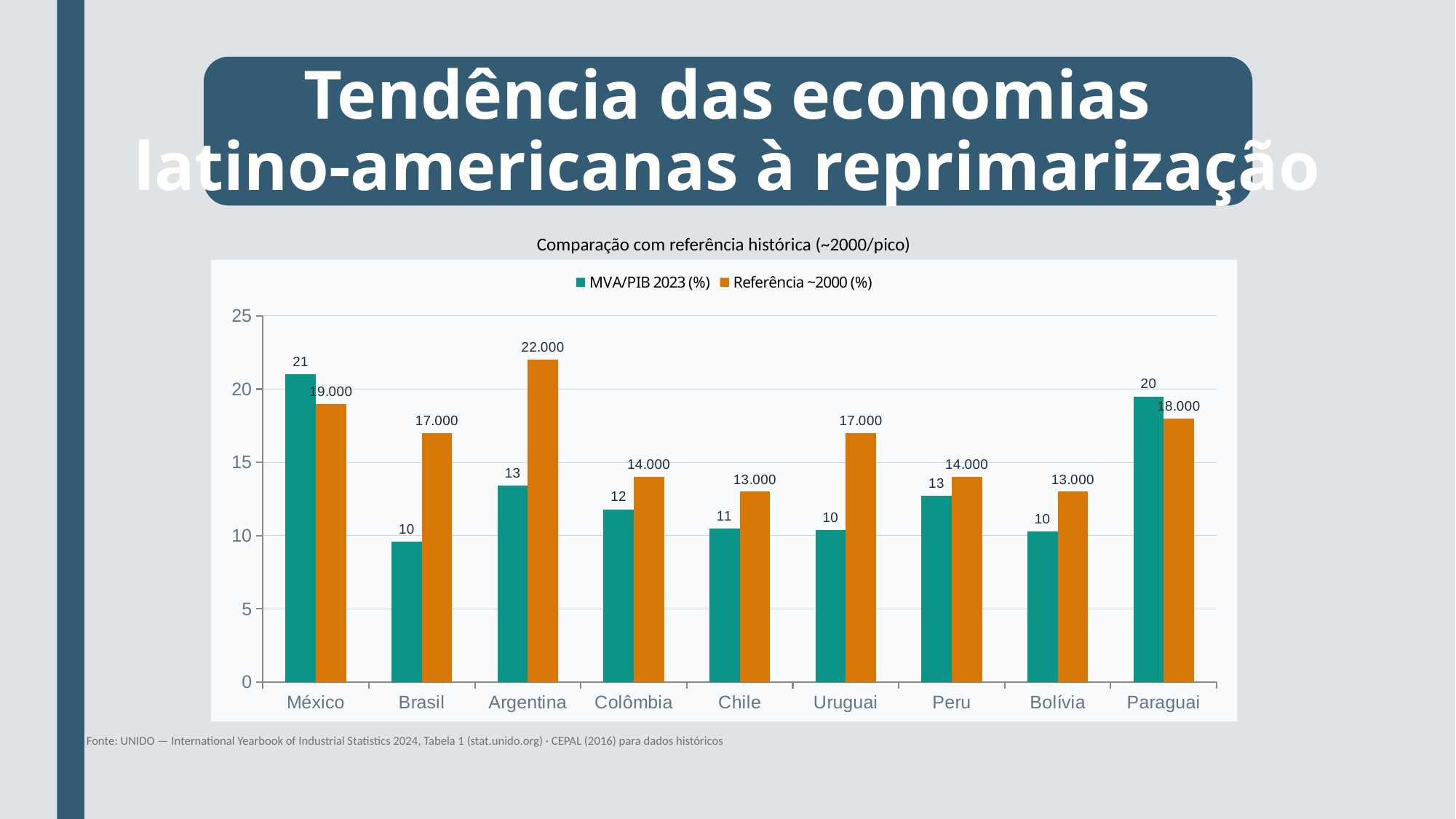
What is the difference between the Referência ~2000 (%) value and the MVA/PIB 2023 (%) value for Argentina, using the printed labels? 9 What is the Referência ~2000 (%) value for Uruguai? 17.000 What is the Referência ~2000 (%) value for Argentina? 22.000 For México, which is larger: the MVA/PIB 2023 (%) value or the Referência ~2000 (%) value? MVA/PIB 2023 (%) How many series does the chart legend list? 2 Is the MVA/PIB 2023 (%) value for Uruguai greater or less than 15? less Which country has the highest Referência ~2000 (%) value? Argentina What is the MVA/PIB 2023 (%) value for México? 21 Which country has the highest MVA/PIB 2023 (%) value? México What is the MVA/PIB 2023 (%) value for Paraguai? 20 How many countries are shown on the x axis of the chart? 9 What kind of chart is shown on the slide? bar chart